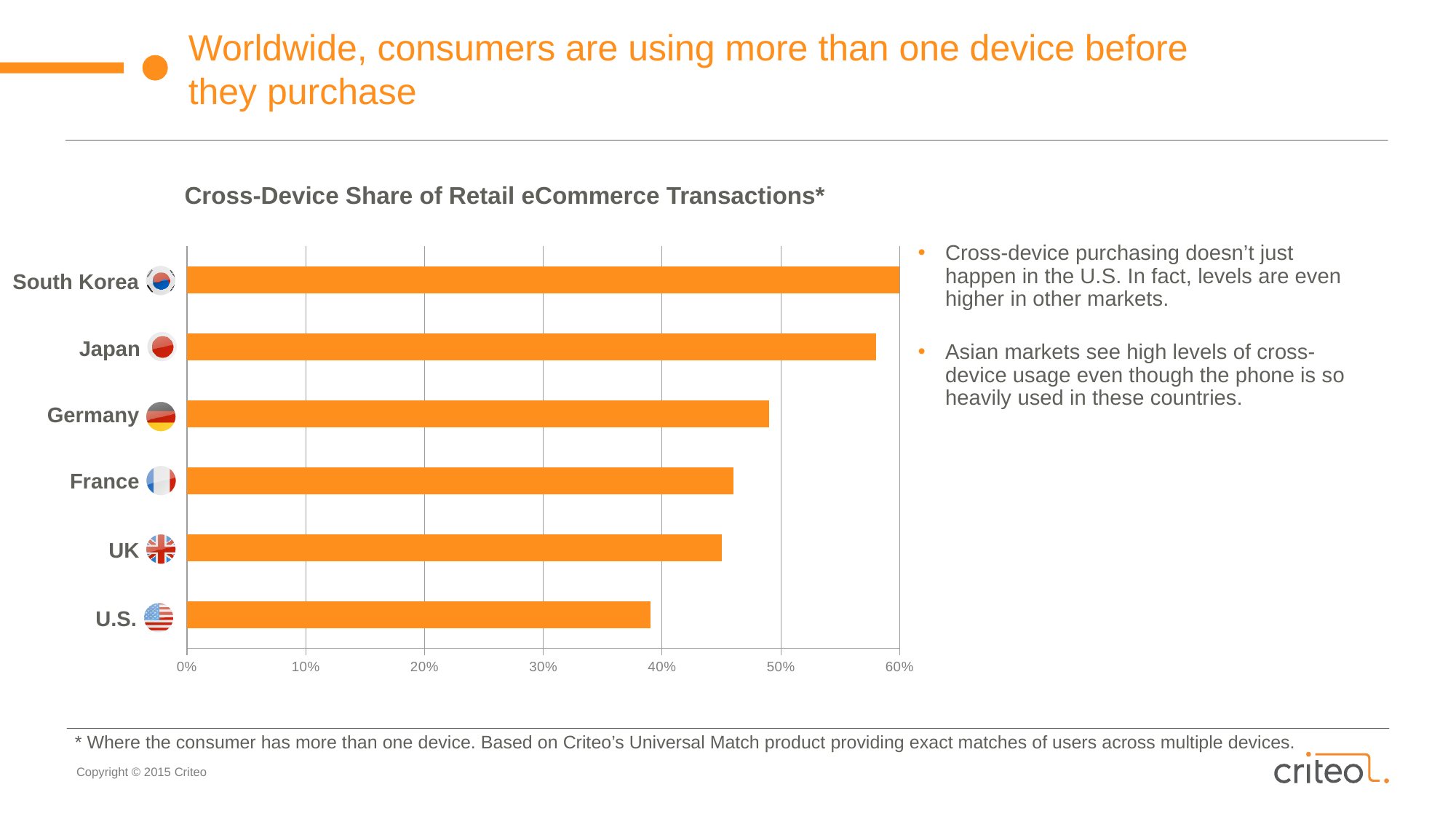
Is the value for Germany greater or less than 50%? less What is the title of the chart? Cross-Device Share of Retail eCommerce Transactions* What kind of chart is shown on the slide? bar chart Is the value for France greater or less than 40%? greater Is the value for the UK greater or less than 50%? less Which country has the highest cross-device share of retail eCommerce transactions? South Korea Which has a higher cross-device share, Germany or the U.S.? Germany Which has a higher cross-device share, Japan or Germany? Japan How many countries are shown in the chart? 6 Which country has the lowest cross-device share of retail eCommerce transactions? U.S.